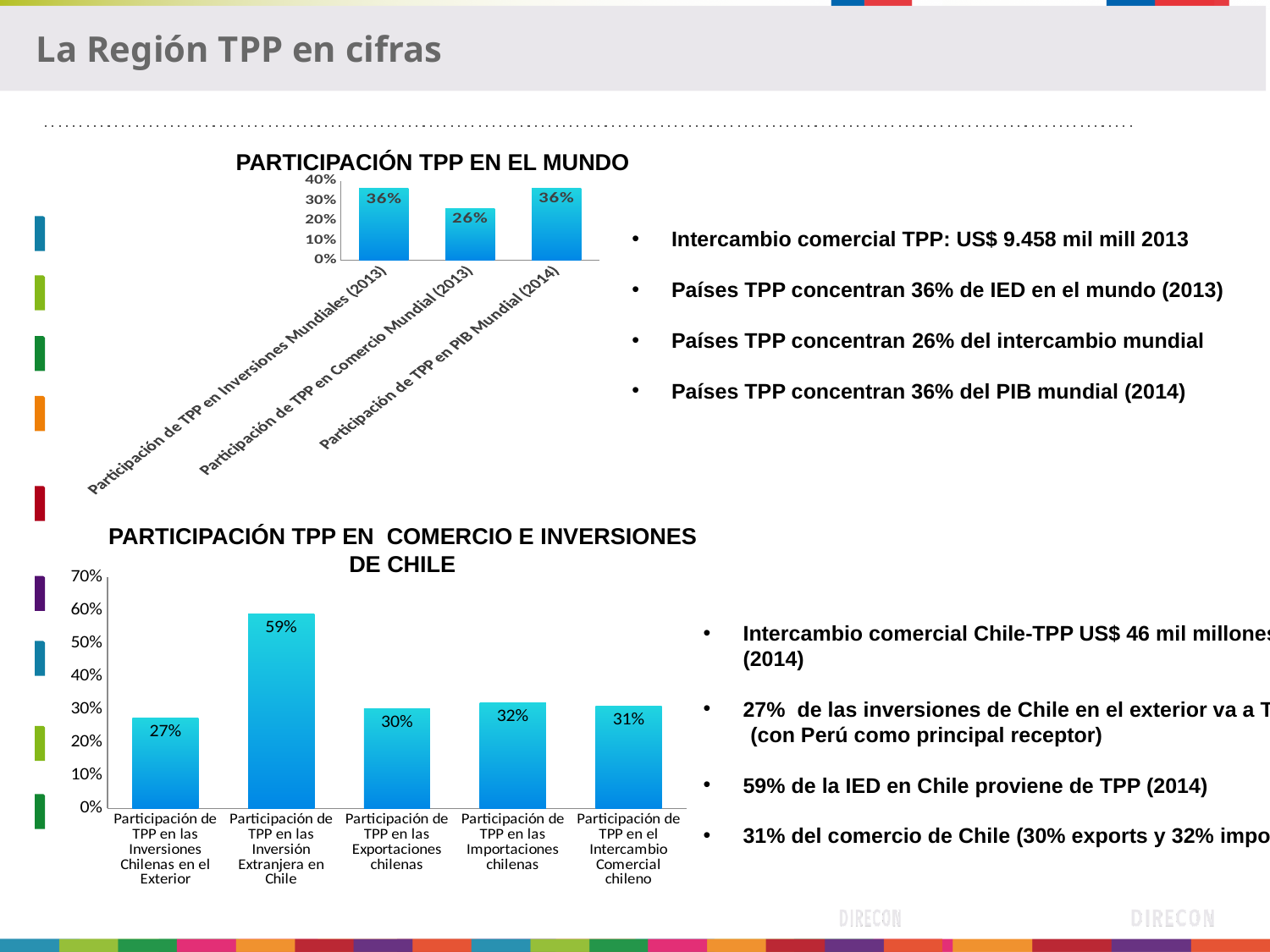
In the chart 'PARTICIPACIÓN TPP EN COMERCIO E INVERSIONES DE CHILE', what is the value for 'Participación de TPP en la Inversión Extranjera en Chile'? 59% In the chart 'PARTICIPACIÓN TPP EN EL MUNDO', what is the difference between the value for 'Participación de TPP en Inversiones Mundiales (2013)' and the value for 'Participación de TPP en Comercio Mundial (2013)'? 10% In the chart 'PARTICIPACIÓN TPP EN COMERCIO E INVERSIONES DE CHILE', what is the difference between the value for 'Participación de TPP en la Inversión Extranjera en Chile' and the value for 'Participación de TPP en las Inversiones Chilenas en el Exterior'? 32% In the chart 'PARTICIPACIÓN TPP EN COMERCIO E INVERSIONES DE CHILE', what is the value for 'Participación de TPP en las Importaciones chilenas'? 32% In the chart 'PARTICIPACIÓN TPP EN COMERCIO E INVERSIONES DE CHILE', how many categories are plotted? 5 In the chart 'PARTICIPACIÓN TPP EN EL MUNDO', what is the value for 'Participación de TPP en PIB Mundial (2014)'? 36% In the chart 'PARTICIPACIÓN TPP EN EL MUNDO', what is the value for 'Participación de TPP en Comercio Mundial (2013)'? 26% In the chart 'PARTICIPACIÓN TPP EN EL MUNDO', how many bars are plotted? 3 What type of chart is 'PARTICIPACIÓN TPP EN COMERCIO E INVERSIONES DE CHILE'? Bar chart In the chart 'PARTICIPACIÓN TPP EN EL MUNDO', which category has the lowest value? Participación de TPP en Comercio Mundial (2013) In the chart 'PARTICIPACIÓN TPP EN COMERCIO E INVERSIONES DE CHILE', which category has the lowest value? Participación de TPP en las Inversiones Chilenas en el Exterior In the chart 'PARTICIPACIÓN TPP EN COMERCIO E INVERSIONES DE CHILE', which category has the highest value? Participación de TPP en la Inversión Extranjera en Chile